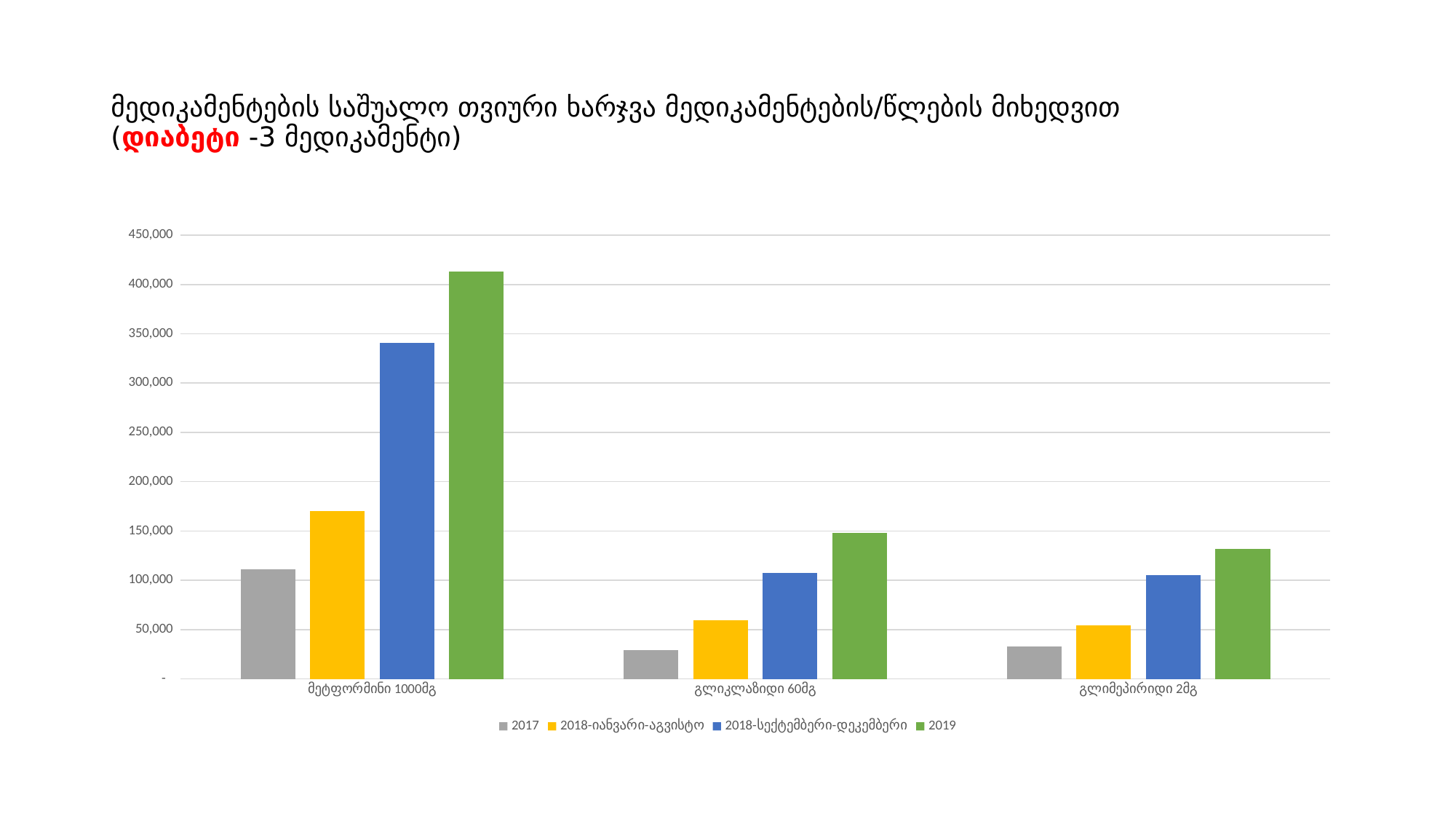
For მეტფორმინი 1000მგ, do the values rise or fall from the 2017 series to the 2019 series? rise How many series does the legend list? 4 Which category has the lowest value for the 2019 series? გლიმეპირიდი 2მგ What kind of chart is shown on the slide? bar chart What colour represents the 2019 series in the legend? green How many medication categories are shown on the x axis? 3 Which category has the highest value for the 2019 series? მეტფორმინი 1000მგ Which is larger: the 2019 value for გლიკლაზიდი 60მგ or the 2019 value for გლიმეპირიდი 2მგ? გლიკლაზიდი 60მგ Is the 2018-სექტემბერი-დეკემბერი value for მეტფორმინი 1000მგ greater or less than 350,000? less Is the 2019 value for მეტფორმინი 1000მგ greater or less than 400,000? greater Is the 2017 value for მეტფორმინი 1000მგ greater or less than 100,000? greater